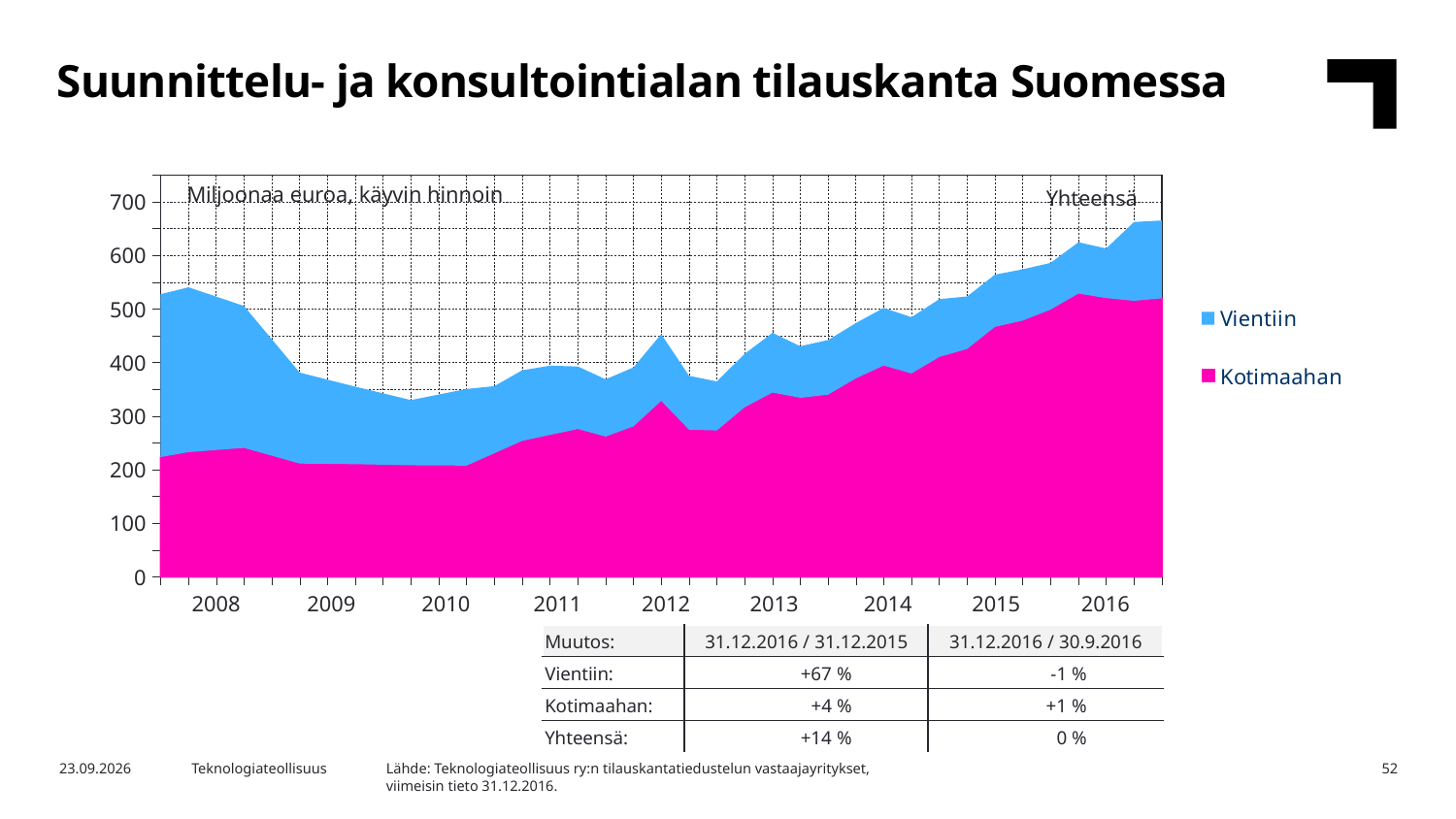
According to the table below the chart, what is the change in Kotimaahan for 31.12.2016 / 31.12.2015? +4 % How many series does the chart legend list? 2 Is the Kotimaahan value at the start of 2010 greater or less than 300? less Is the total (Yhteensä) value at the end of 2016 greater or less than 600? greater According to the table below the chart, what is the change in Yhteensä for 31.12.2016 / 30.9.2016? 0 % Which two series are listed in the chart legend? Vientiin and Kotimaahan According to the table below the chart, what is the change in Vientiin for 31.12.2016 / 31.12.2015? +67 % Does the Kotimaahan series rise or fall between 2010 and 2016? rise Is the Kotimaahan value at the end of 2016 greater or less than 400? greater What kind of chart is shown on the slide? Stacked area chart What unit is stated in the chart's subtitle? Miljoonaa euroa, käyvin hinnoin How many years are labelled on the x axis of the chart? 9